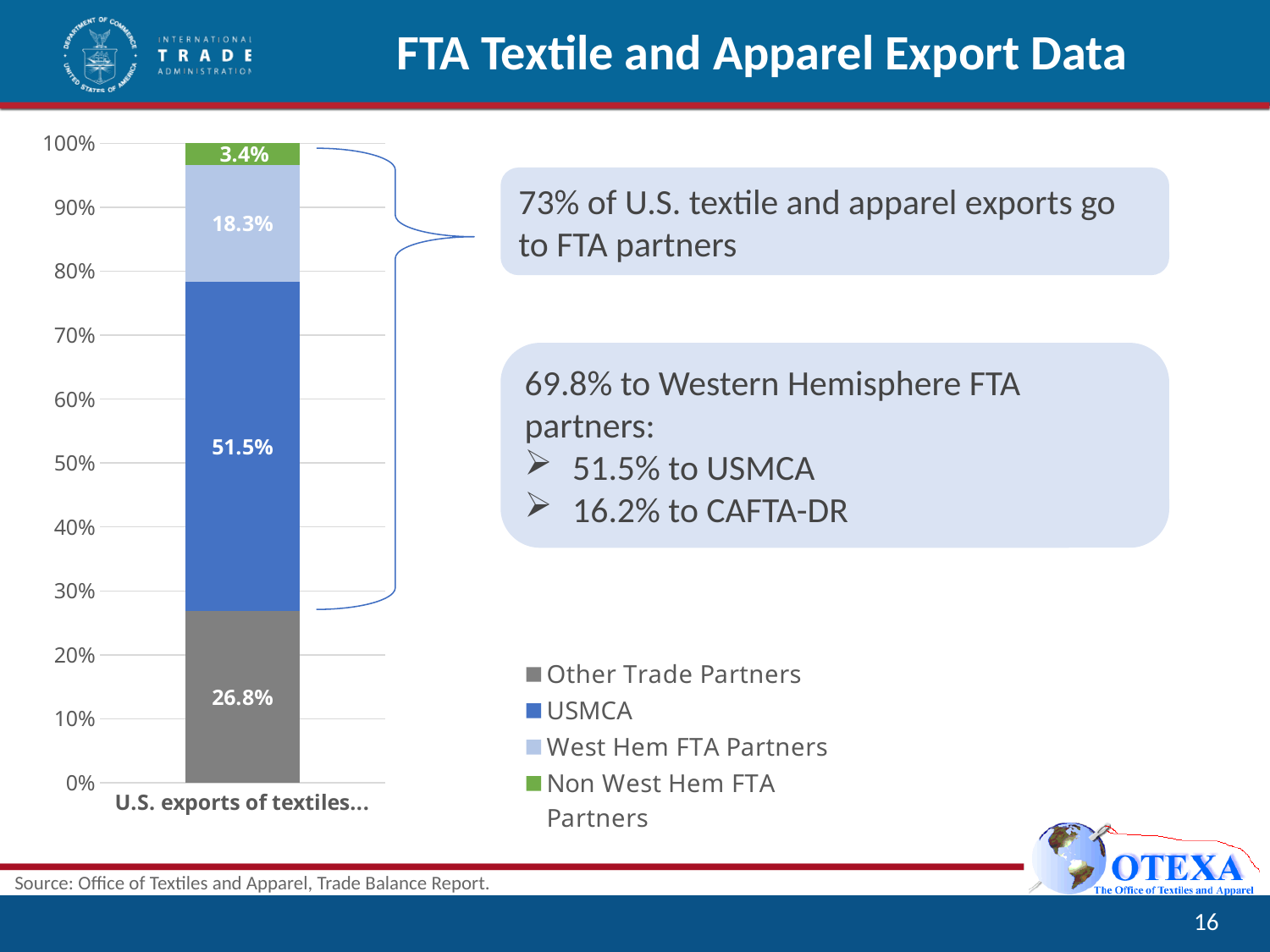
What is the difference between the USMCA segment and the Other Trade Partners segment? 24.7% Which series has the largest segment in the stacked bar? USMCA What share of U.S. textile exports goes to USMCA according to the chart? 51.5% What kind of chart is shown on the slide? Stacked bar chart What value is shown for Other Trade Partners in the stacked bar? 26.8% Which series has the smallest segment in the stacked bar? Non West Hem FTA Partners What value is shown for Non West Hem FTA Partners in the stacked bar? 3.4% How many series does the legend list? 4 Which is larger, the West Hem FTA Partners segment or the Other Trade Partners segment? Other Trade Partners What is the total of all segments in the stacked bar? 100% What value is shown for West Hem FTA Partners in the stacked bar? 18.3% What colour is the USMCA segment in the chart? Blue